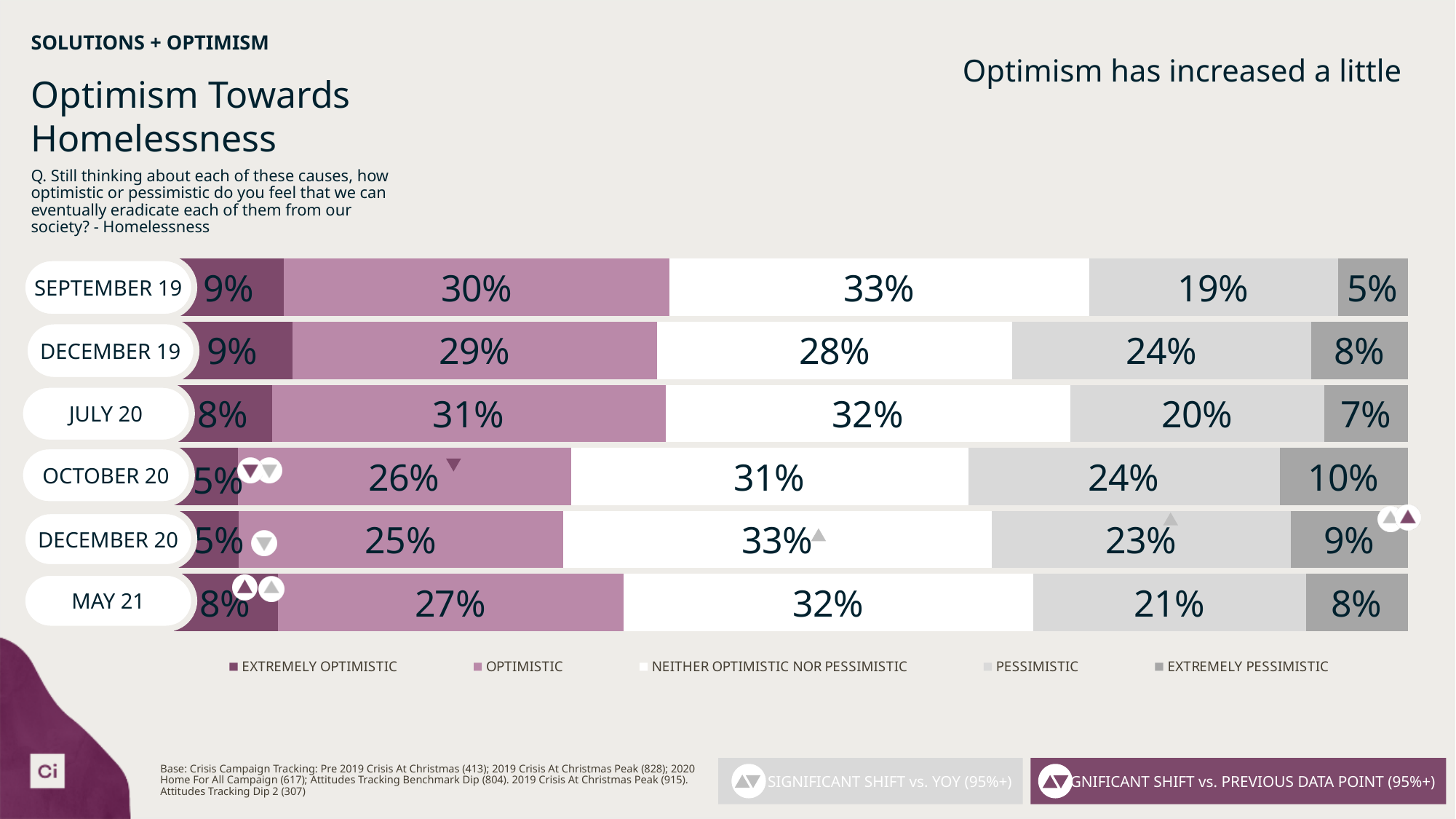
Which period has the lowest Extremely Pessimistic value? September 19 What kind of chart is shown on the slide? Stacked bar chart Which period has the larger Neither Optimistic Nor Pessimistic value, September 19 or December 19? September 19 Which period has the highest Optimistic value? July 20 What is the Neither Optimistic Nor Pessimistic value for December 20? 33% What is the first entry in the chart legend? Extremely Optimistic What is the sum of the printed values in the May 21 bar? 96% What is the Extremely Pessimistic value for October 20? 10% How many series does the legend list? 5 By how many percentage points did the Pessimistic value change from September 19 to December 19? 5 percentage points How many time periods are shown in the chart? 6 What percentage of respondents were Optimistic about homelessness in July 20? 31%